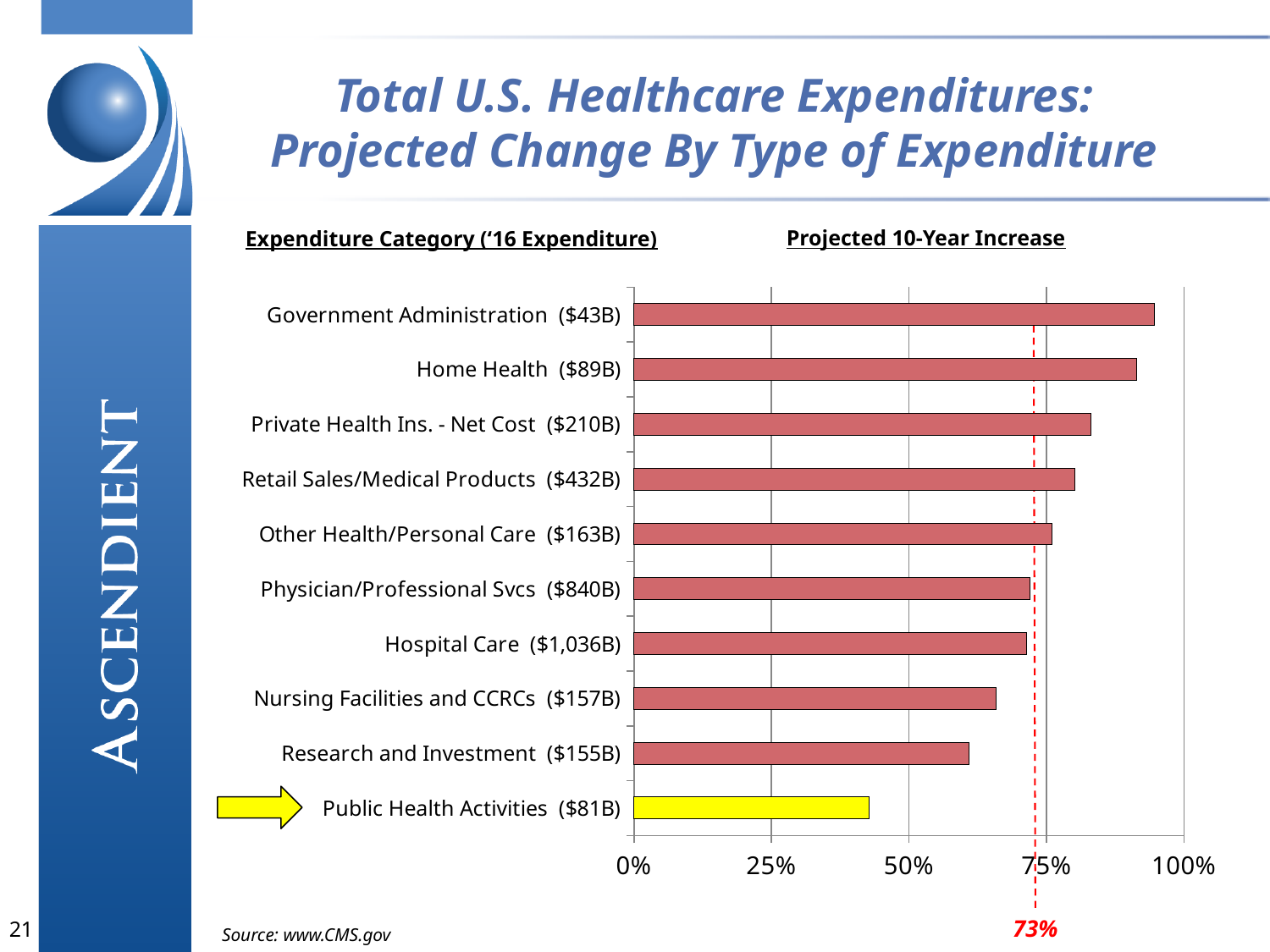
Is the projected 10-year increase for Public Health Activities greater or less than 50%? less Which has the larger projected 10-year increase, Private Health Ins. - Net Cost or Research and Investment? Private Health Ins. - Net Cost What kind of chart is shown on the slide? bar chart Which expenditure category has the highest projected 10-year increase? Government Administration ($43B) Is the projected 10-year increase for Nursing Facilities and CCRCs greater or less than 75%? less Is the projected 10-year increase for Research and Investment greater or less than 50%? greater Do the projected 10-year increases rise or fall going from the top category to the bottom category? fall Which expenditure category's bar is highlighted in yellow? Public Health Activities ($81B) What value is marked by the red dashed vertical line on the chart? 73% How many expenditure categories are plotted in the chart? 10 Which expenditure category has the lowest projected 10-year increase? Public Health Activities ($81B)